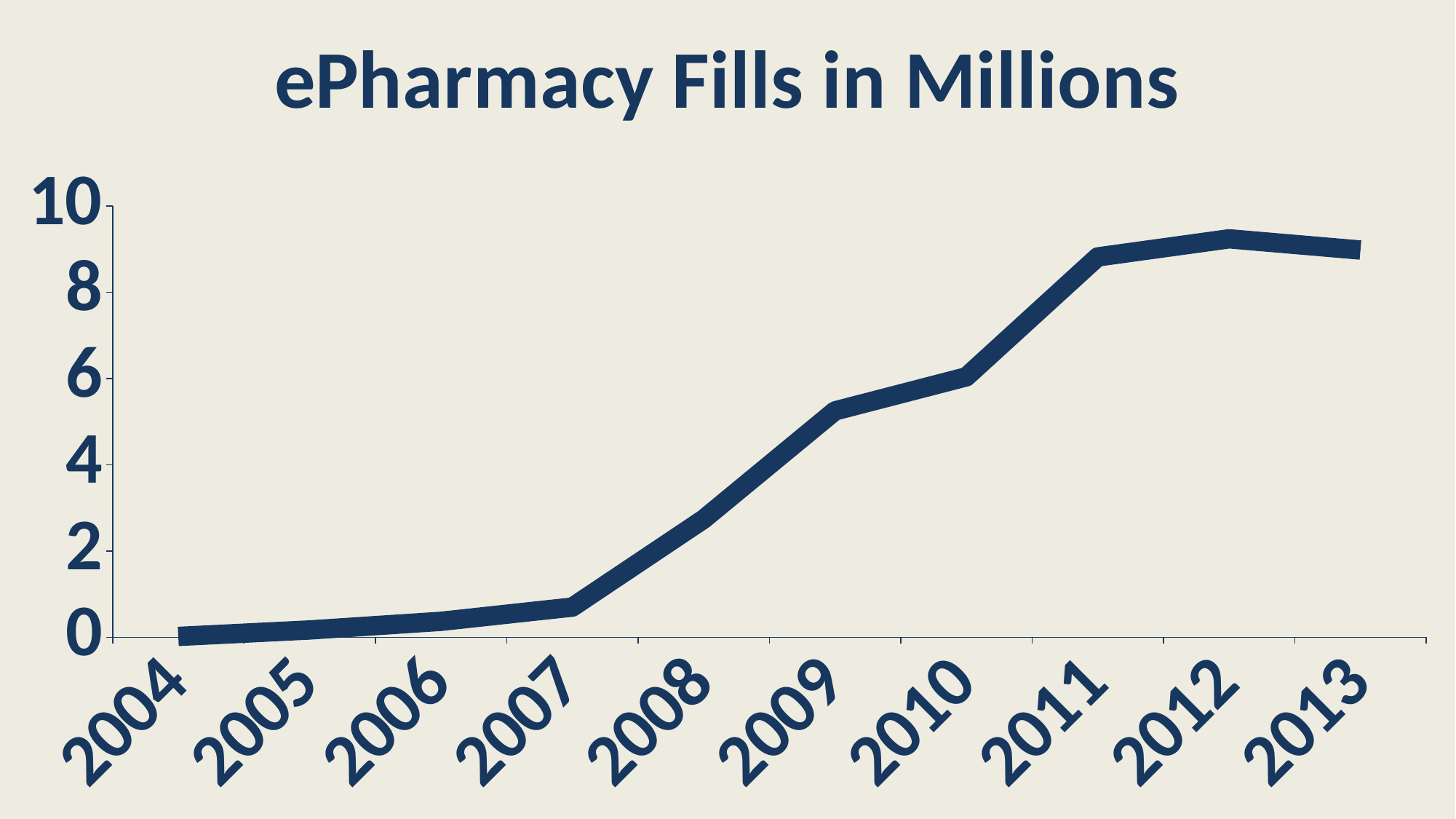
Do the values generally rise or fall from 2004 to 2011? rise How many years are plotted on the x axis? 10 Which is larger, the value for 2011 or the value for 2010? 2011 What kind of chart is shown on the slide? line chart Is the value for 2009 greater or less than 4? greater Which year has the lowest value? 2004 Is the value for 2008 greater or less than 4? less Is the value for 2013 greater or less than 6? greater What is the title of the chart? ePharmacy Fills in Millions Which is larger, the value for 2009 or the value for 2008? 2009